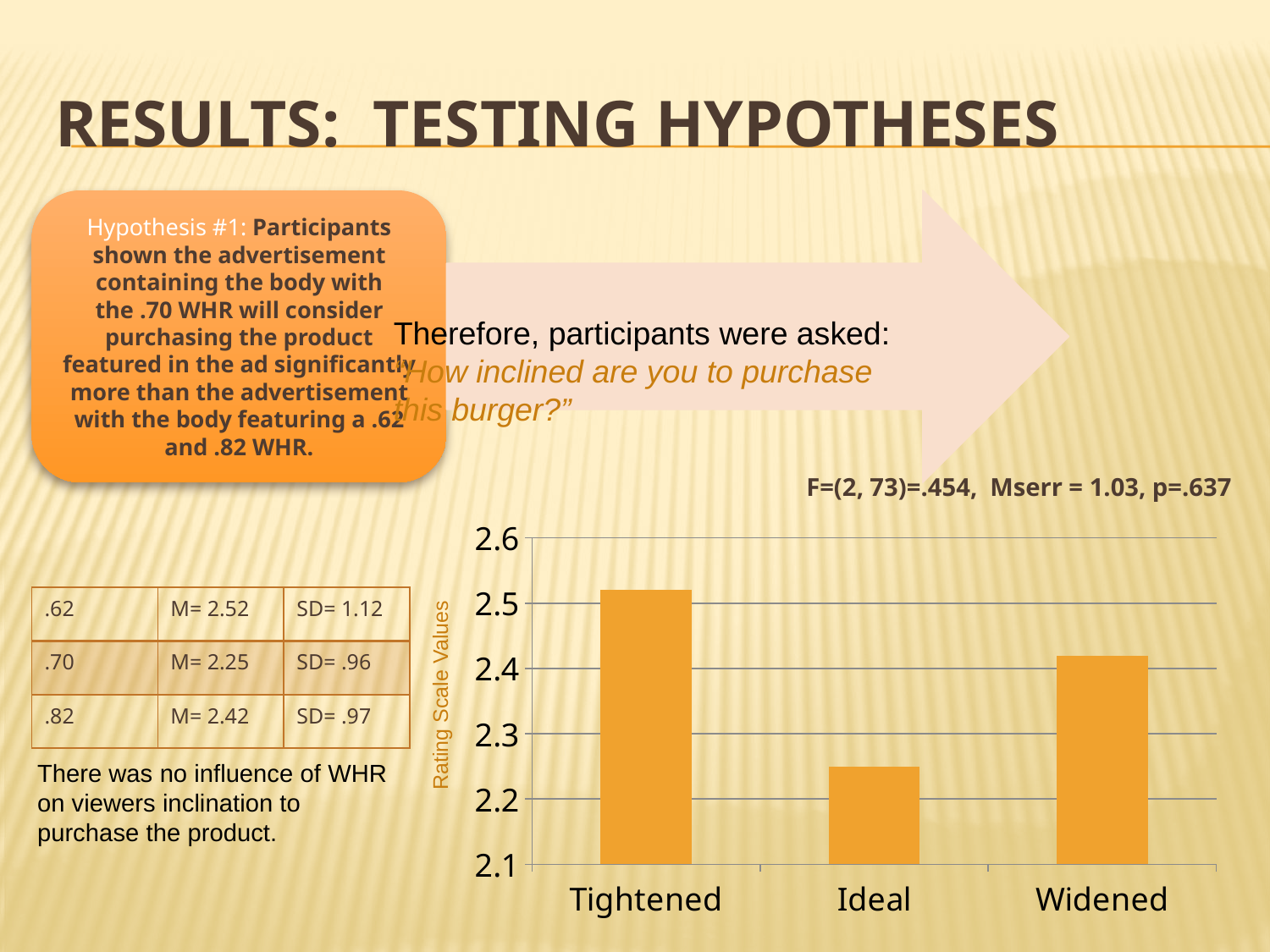
What kind of chart is shown on the slide? bar chart Is the value for Widened greater or less than 2.5? less Is the value for Ideal greater or less than 2.3? less Which category has the lowest bar in the chart? Ideal Is the value for Tightened greater or less than 2.4? greater Which category has the highest bar in the chart? Tightened Which has the larger value, Ideal or Widened? Widened Does the value rise or fall from Tightened to Ideal? fall What is the highest value shown on the vertical axis of the chart? 2.6 What is the label on the vertical axis of the chart? Rating Scale Values Which has the larger value, Tightened or Widened? Tightened How many categories are shown on the x axis of the chart? 3